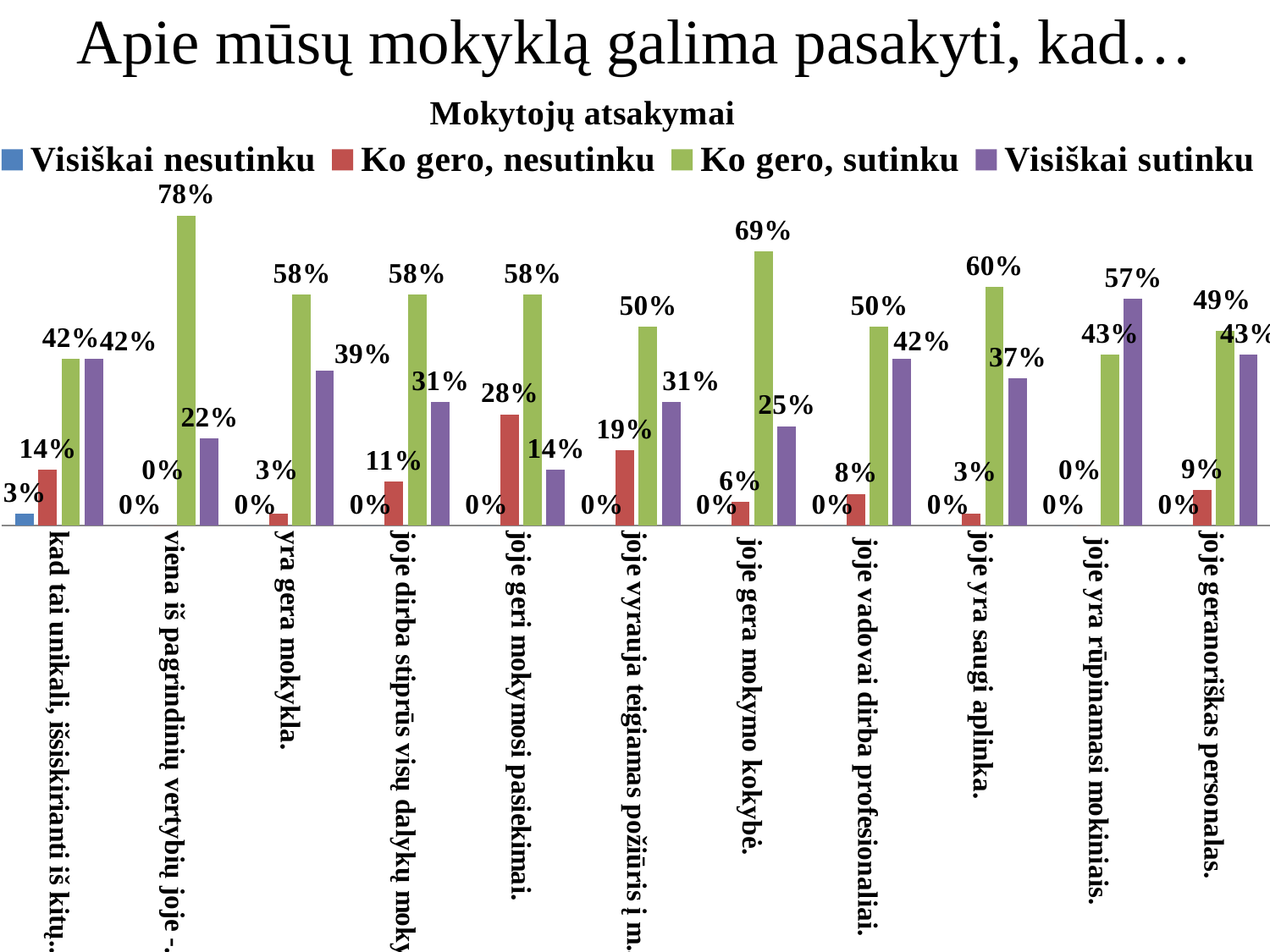
How many categories (statements) are shown on the x axis? 11 What is the value of "Visiškai sutinku" for "joje yra rūpinamasi mokiniais."? 57% How many series does the legend list? 4 What kind of chart is shown on the slide? bar chart What is the value of "Ko gero, sutinku" for "joje gera mokymo kokybė."? 69% What is the value of "Visiškai nesutinku" for "kad tai unikali, išsiskirianti iš kitų..."? 3% What is the value of "Ko gero, nesutinku" for "joje geri mokymosi pasiekimai."? 28% Which category has the highest "Ko gero, sutinku" value? viena iš pagrindinių vertybių joje -... For "joje vadovai dirba profesionaliai.", which is larger: "Ko gero, sutinku" or "Visiškai sutinku"? Ko gero, sutinku Which category has the lowest "Visiškai sutinku" value? joje geri mokymosi pasiekimai. What is the difference between the "Ko gero, sutinku" and "Visiškai sutinku" values for "joje yra saugi aplinka."? 23% What is the title of the chart? Mokytojų atsakymai